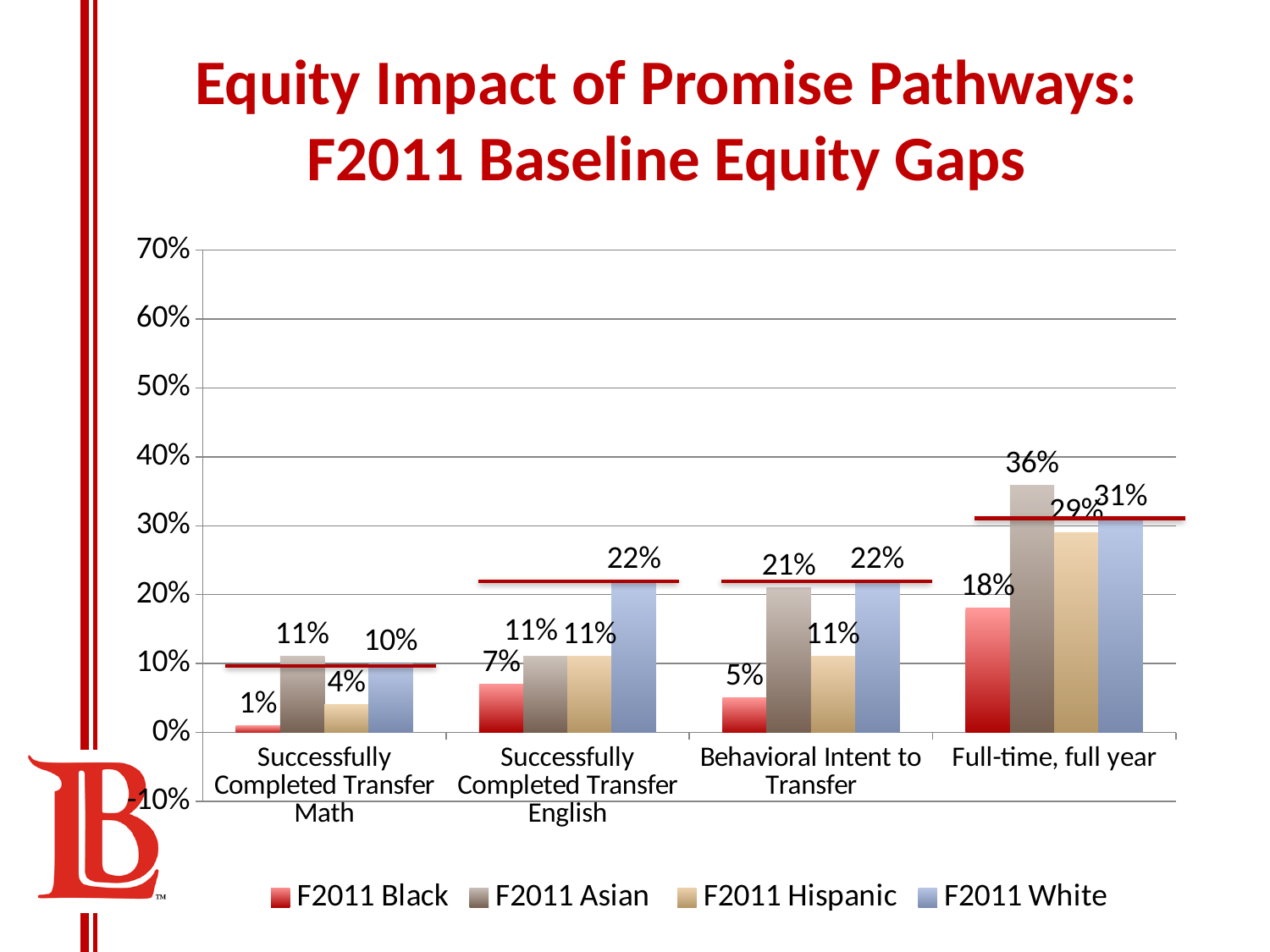
What kind of chart is shown on the slide? Bar chart Which series has the highest value in the Full-time, full year category? F2011 Asian How many series does the legend list? 4 How many categories are shown on the x axis? 4 Which is larger in the Full-time, full year category: the F2011 Hispanic value or the F2011 Black value? F2011 Hispanic What is the value for F2011 Black in the Successfully Completed Transfer Math category? 1% Which series has the lowest value in the Successfully Completed Transfer Math category? F2011 Black Do the F2011 Black values rise or fall from the Behavioral Intent to Transfer category to the Full-time, full year category? Rise What is the value for F2011 Asian in the Full-time, full year category? 36% What is the difference between the F2011 White and F2011 Black values in the Behavioral Intent to Transfer category? 17% What is the value for F2011 Hispanic in the Behavioral Intent to Transfer category? 11% What is the value for F2011 White in the Successfully Completed Transfer English category? 22%